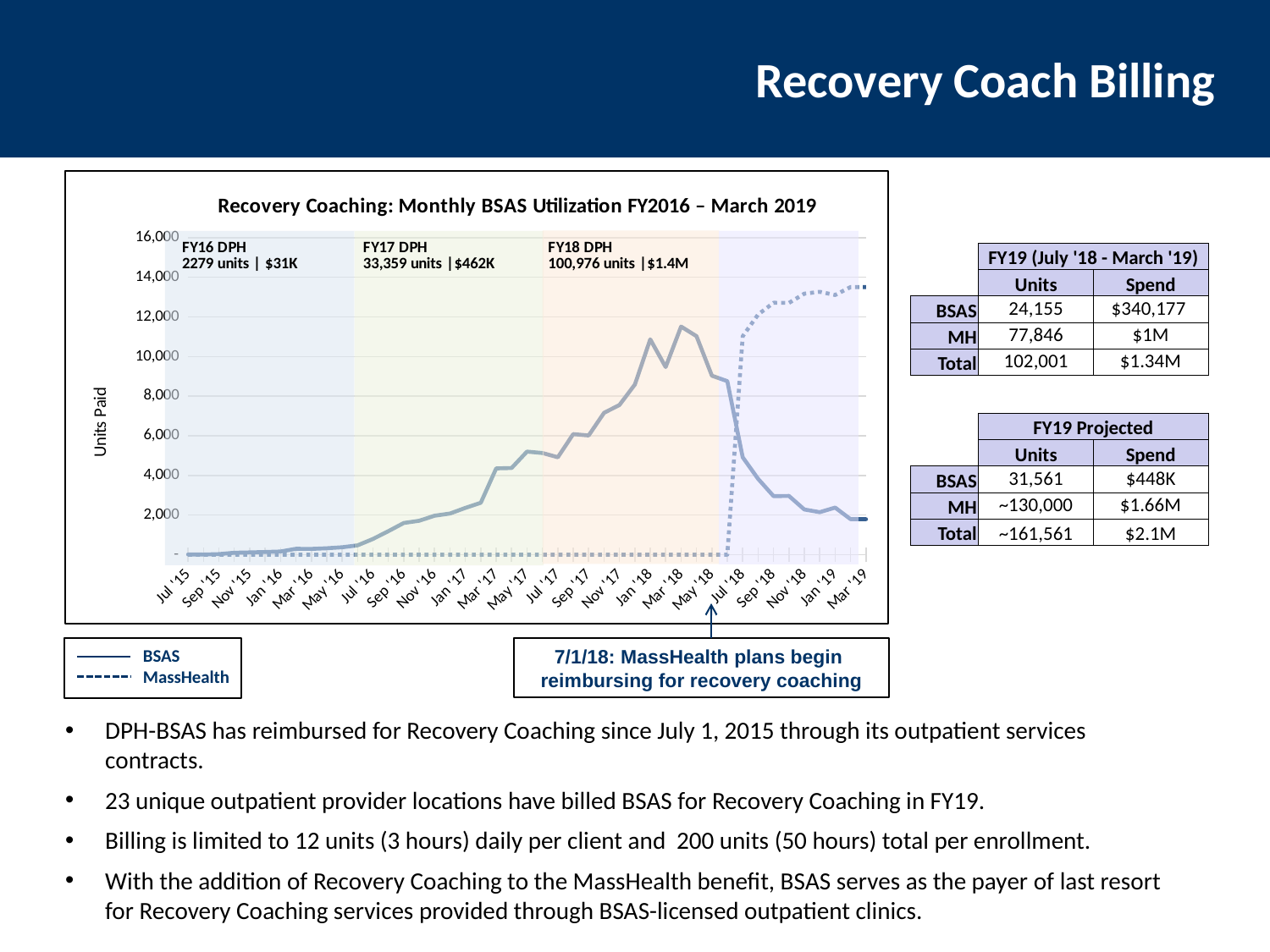
In Mar '19, which series has the higher value, BSAS or MassHealth? MassHealth Which series is drawn with a dashed line in the chart? MassHealth How many series does the chart's legend list? 2 Is the highest BSAS value on the chart greater or less than 10,000? greater Is the MassHealth value for Jan '18 greater or less than 2,000? less Does the BSAS line generally rise or fall from Jul '18 to Mar '19? fall What is the title of the chart? Recovery Coaching: Monthly BSAS Utilization FY2016 – March 2019 Is the MassHealth value for Mar '19 greater or less than 12,000? greater What kind of chart is shown on the slide? line chart According to the annotation on the chart, how many units were paid by DPH in FY17? 33,359 units In Jan '18, which series has the higher value, BSAS or MassHealth? BSAS